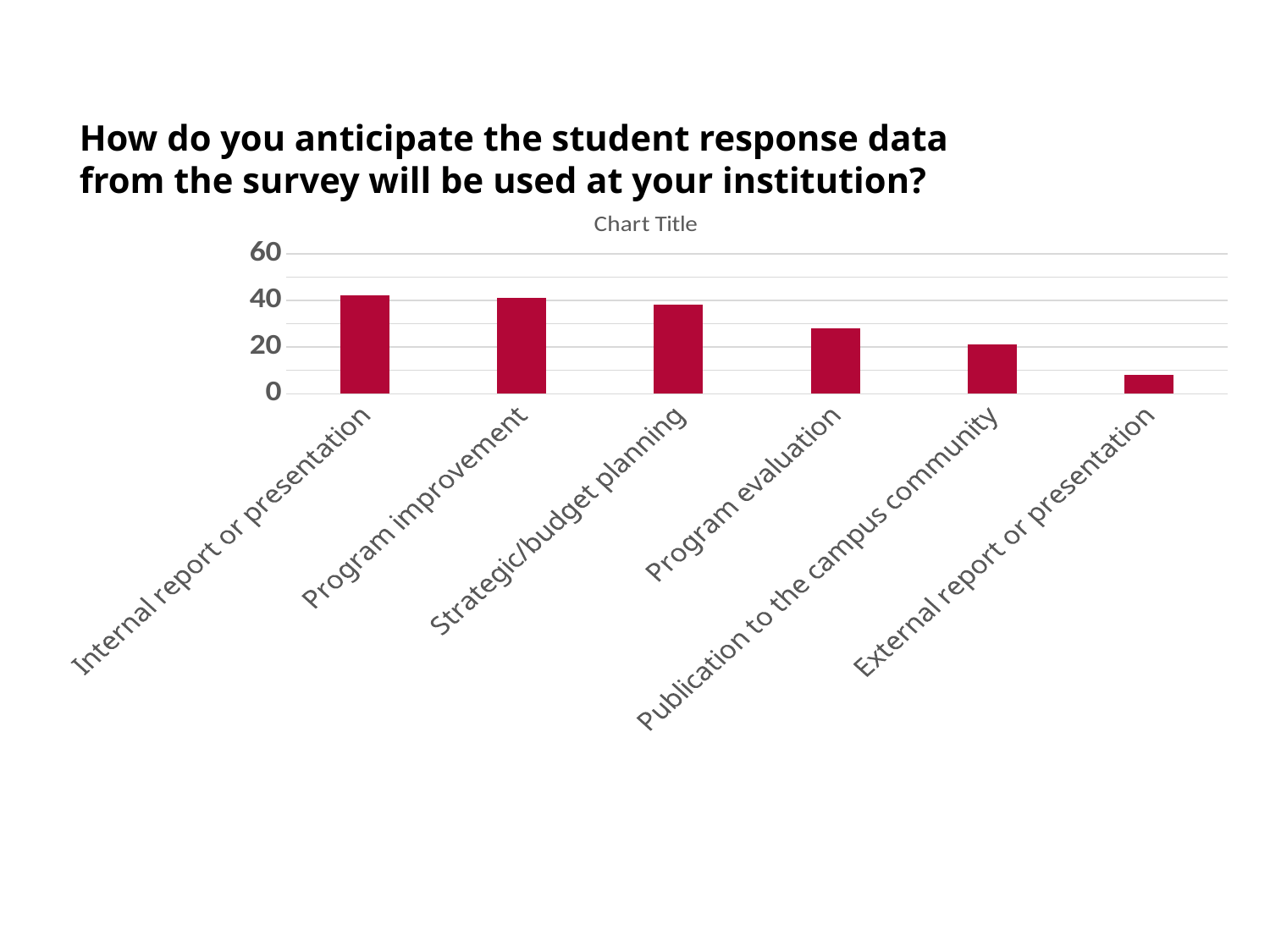
Which is larger: the value for Program improvement or the value for Publication to the campus community? Program improvement Do the bar values rise or fall from left to right across the chart? fall What kind of chart is shown on the slide? bar chart Which category has the lowest value in the chart? External report or presentation Is the value for External report or presentation greater or less than 20? less Is the value for Program evaluation greater or less than 40? less Is the value for Program evaluation greater or less than 20? greater Which is larger: the value for Internal report or presentation or the value for Program evaluation? Internal report or presentation Which is larger: the value for Publication to the campus community or the value for External report or presentation? Publication to the campus community How many categories are shown on the x axis of the chart? 6 What is the title printed directly above the chart's plot area? Chart Title